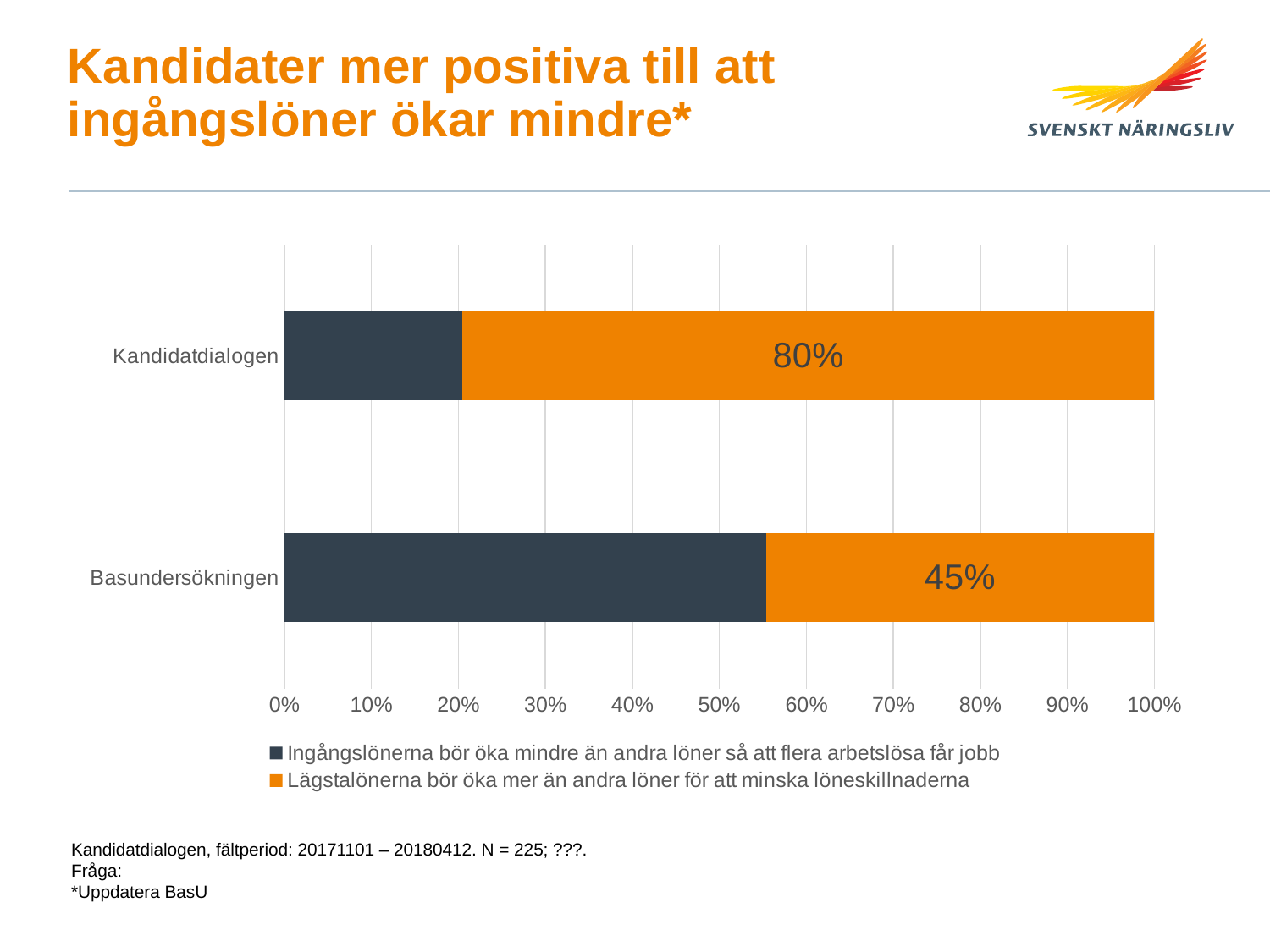
How many series does the legend list? 2 Which category has the lowest value for the orange series? Basundersökningen How many categories are shown on the chart? 2 What is the value of the orange series (Lägstalönerna bör öka mer än andra löner för att minska löneskillnaderna) for Kandidatdialogen? 80% What is the difference between the orange series values for Kandidatdialogen and Basundersökningen? 35 percentage points Is the value of the dark series (Ingångslönerna bör öka mindre än andra löner så att flera arbetslösa får jobb) for Kandidatdialogen greater or less than 30%? less Which colour represents the series 'Lägstalönerna bör öka mer än andra löner för att minska löneskillnaderna'? Orange Is the value of the dark series (Ingångslönerna bör öka mindre än andra löner så att flera arbetslösa får jobb) for Basundersökningen greater or less than 50%? greater Which category has the higher value for the orange series, Kandidatdialogen or Basundersökningen? Kandidatdialogen What is the value of the orange series (Lägstalönerna bör öka mer än andra löner för att minska löneskillnaderna) for Basundersökningen? 45% What kind of chart is shown on the slide? Stacked bar chart What is the highest value shown on the x axis? 100%